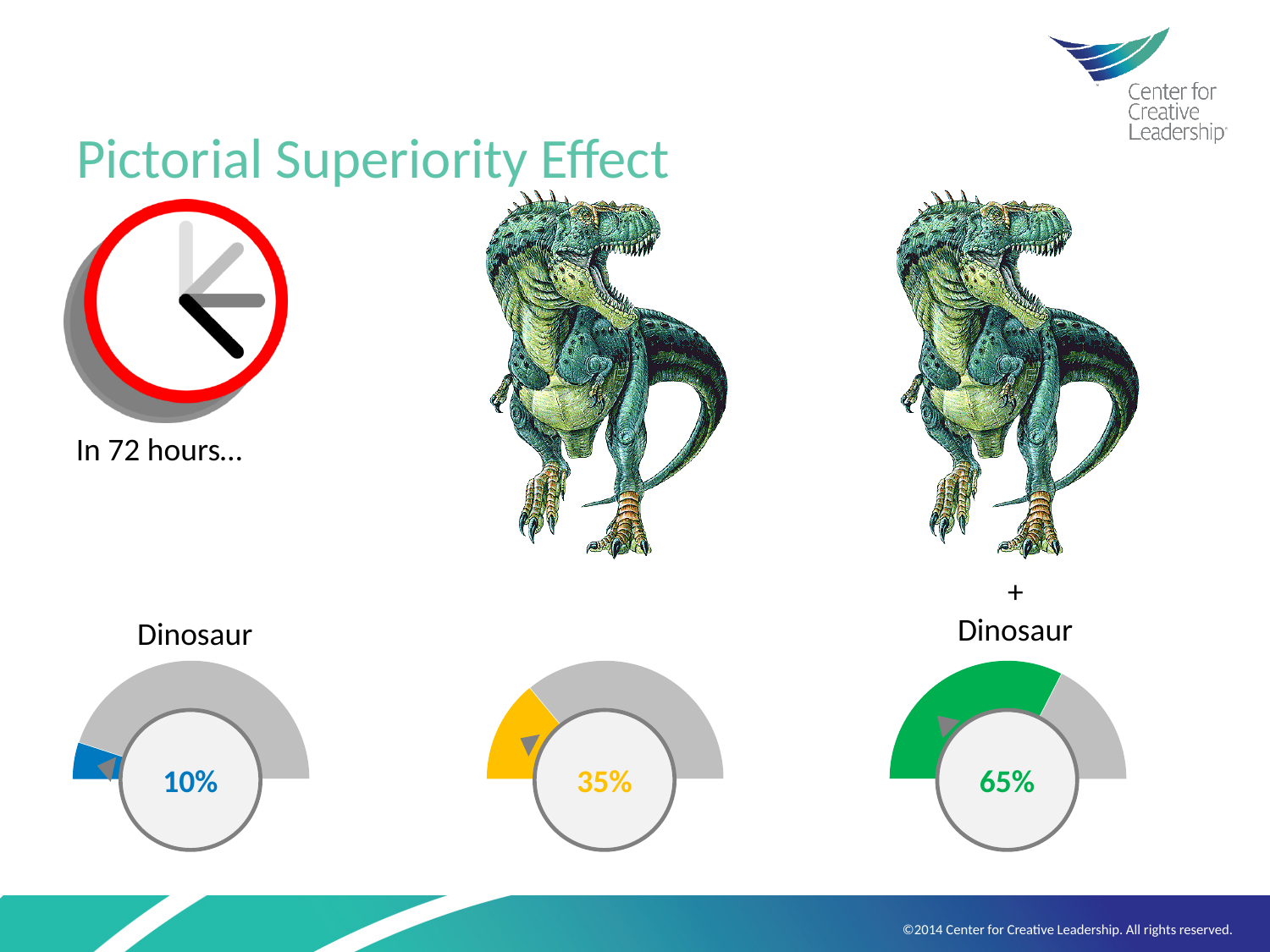
Do the gauge values rise or fall from left to right across the slide? rise How many gauge charts are shown on the slide? 3 Which of the three gauge charts shows the highest value: left, middle or right? right What value is shown on the middle gauge chart? 35% What is the difference between the value on the right gauge chart and the value on the left gauge chart? 55% Which of the three gauge charts shows the lowest value: left, middle or right? left What colour is the filled portion of the right gauge chart showing 65%? green What kind of chart is used to display the percentages at the bottom of the slide? gauge chart What value is shown on the left gauge chart, labelled "Dinosaur"? 10% What is the difference between the value on the middle gauge chart and the value on the left gauge chart? 25% Which is larger, the value on the middle gauge chart or the value on the right gauge chart? right gauge chart (65%) What value is shown on the right gauge chart, under the dinosaur image plus the word "Dinosaur"? 65%